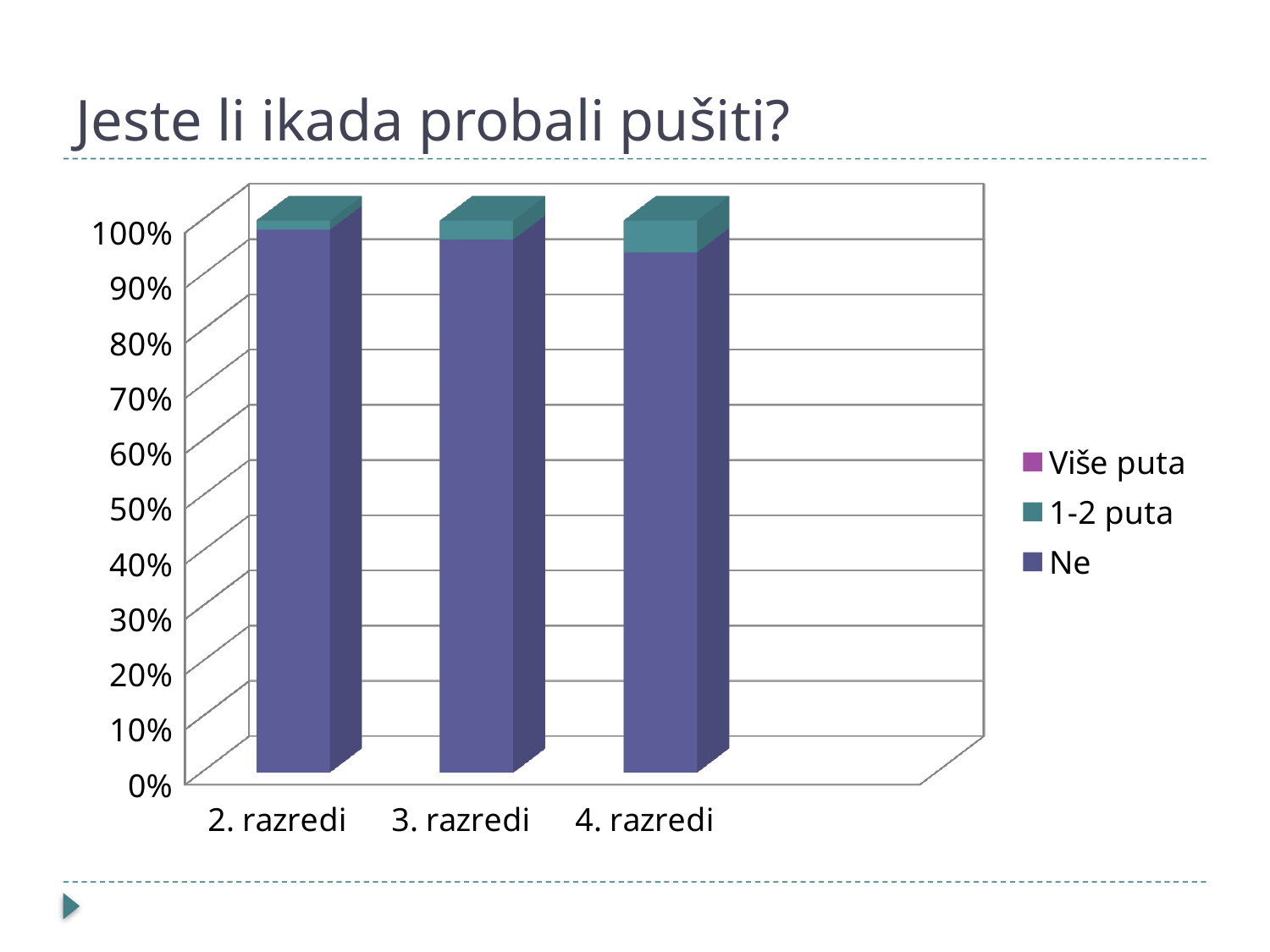
Is the value for Ne in 4. razredi greater or less than 90%? greater Which category has the smallest share for 1-2 puta? 2. razredi Does the share for Ne rise or fall from 2. razredi to 4. razredi? fall Is the value for Ne in 2. razredi greater or less than 90%? greater How many series does the legend list? 3 What kind of chart is shown on the slide? Stacked bar chart How many categories are shown on the x axis? 3 What is the title of the chart? Jeste li ikada probali pušiti? Which series are listed in the legend? Više puta, 1-2 puta, Ne Is the value for 1-2 puta in 4. razredi greater or less than 10%? less Which category has the largest share for 1-2 puta? 4. razredi Is the share for 1-2 puta larger in 2. razredi or in 4. razredi? 4. razredi